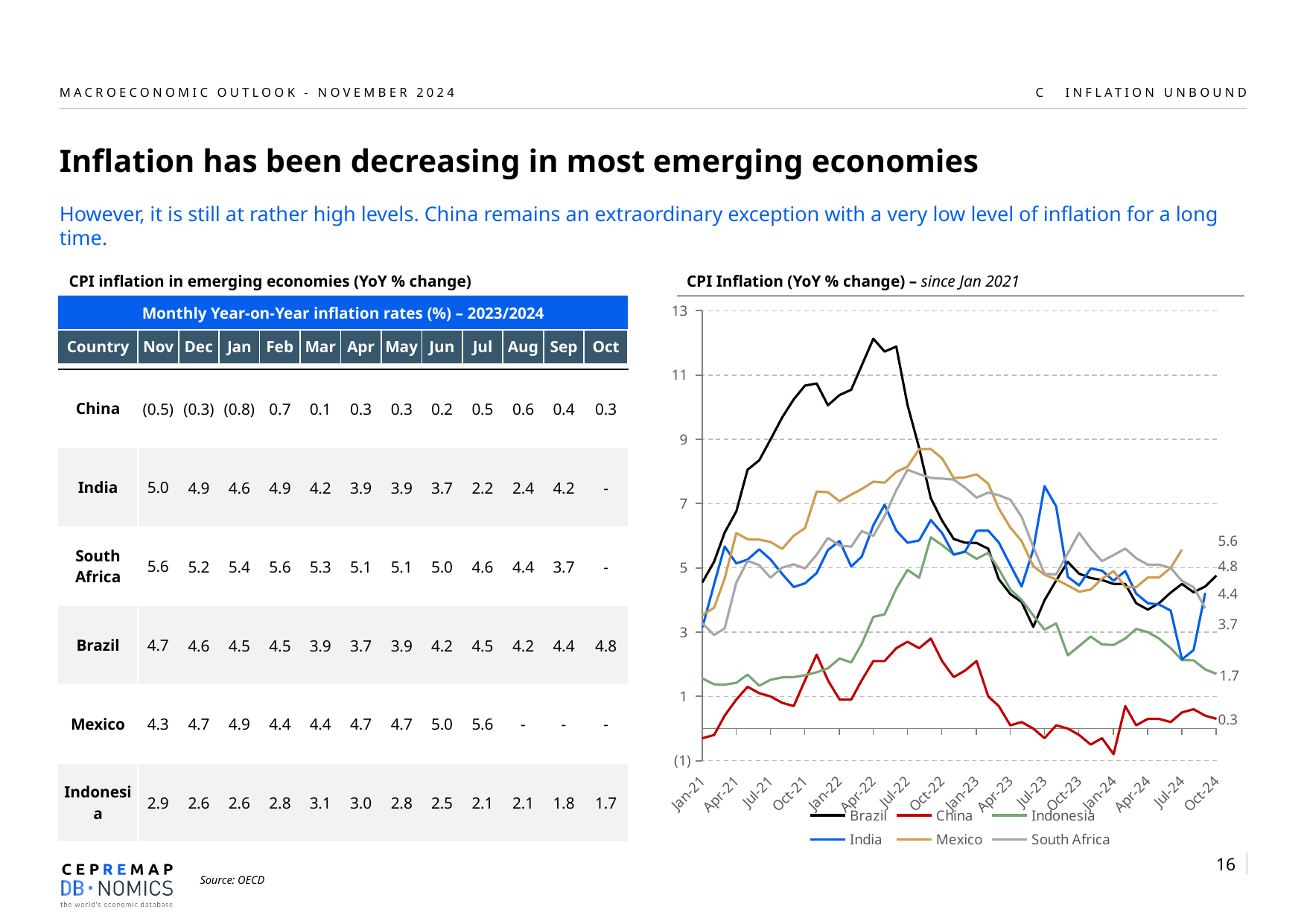
In the CPI Inflation chart, which is larger at the end of the period: the value for Brazil or the value for South Africa? Brazil In the CPI Inflation chart, what is the end-of-period value labelled for Indonesia? 1.7 How many series does the legend of the CPI Inflation chart list? 6 In the CPI Inflation chart, what is the end-of-period value labelled for Brazil? 4.8 In the CPI Inflation chart, does Brazil's line rise or fall between Apr-22 and Jul-23? fall In the CPI Inflation chart, what is the difference between the end-of-period values labelled for Mexico and China? 5.3 What kind of chart is shown on the right side of the slide? line chart In the CPI Inflation chart, is Brazil's peak value around Apr-22 greater or less than 11? greater In the CPI Inflation chart, which country's line reaches the highest value over the whole period? Brazil In the CPI Inflation chart, what is the end-of-period value labelled for Mexico? 5.6 In the CPI Inflation chart, what is the end-of-period value labelled for China? 0.3 In the CPI Inflation chart, which country's line is the lowest at the end of the period (Oct-24)? China